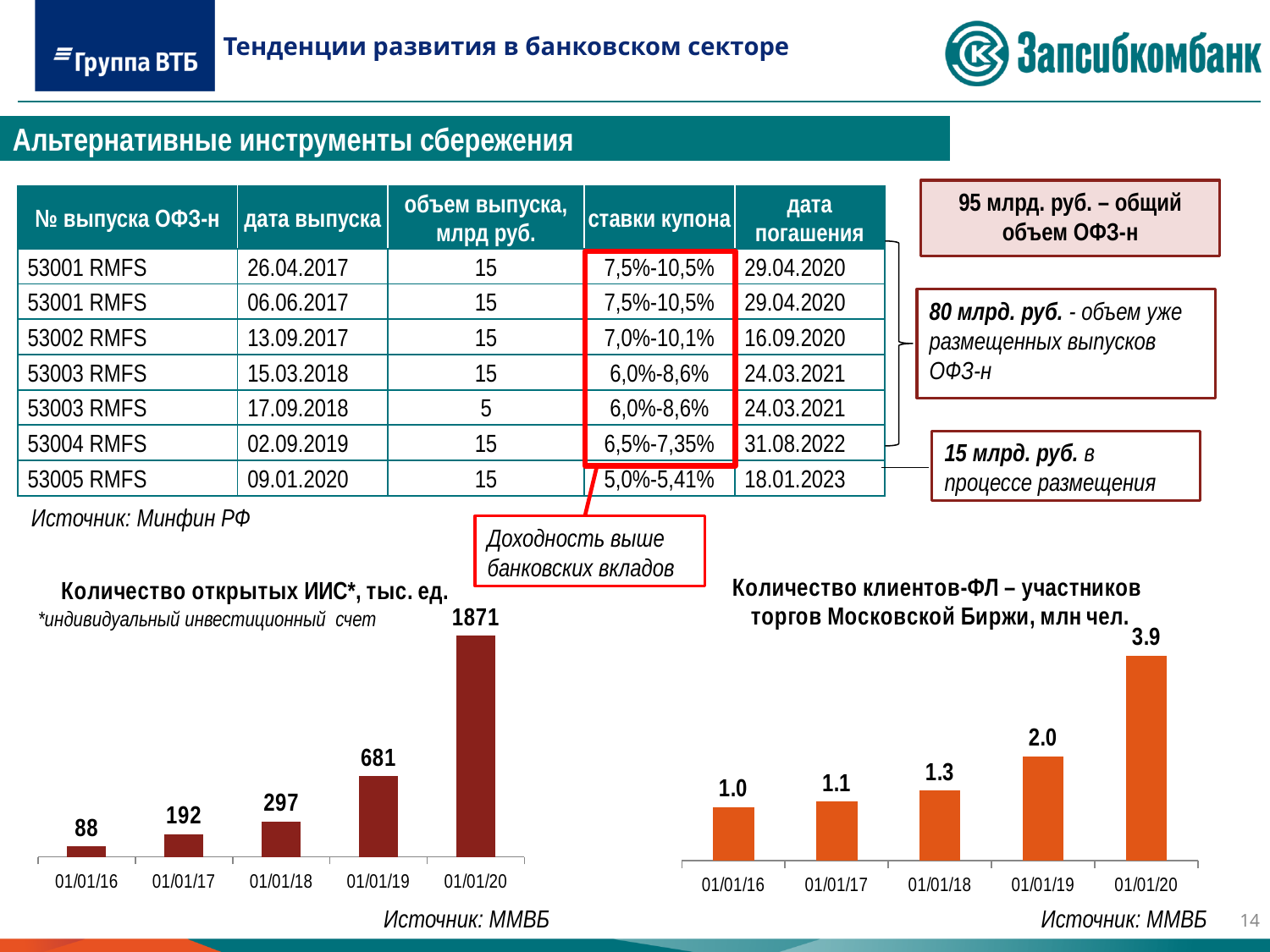
In the chart 'Количество открытых ИИС*, тыс. ед.', what is the value for 01/01/20? 1871 In the chart 'Количество открытых ИИС*, тыс. ед.', what is the difference between the values for 01/01/19 and 01/01/18? 384 In the chart 'Количество клиентов-ФЛ – участников торгов Московской Биржи, млн чел.', what is the value for 01/01/19? 2.0 What type of chart is the chart on the right, 'Количество клиентов-ФЛ – участников торгов Московской Биржи, млн чел.'? bar chart In the chart 'Количество клиентов-ФЛ – участников торгов Московской Биржи, млн чел.', what is the value for 01/01/18? 1.3 In the chart 'Количество клиентов-ФЛ – участников торгов Московской Биржи, млн чел.', which is larger, the value for 01/01/17 or 01/01/18? 01/01/18 In the chart 'Количество клиентов-ФЛ – участников торгов Московской Биржи, млн чел.', which date has the highest value? 01/01/20 In the chart 'Количество открытых ИИС*, тыс. ед.', how many bars are plotted? 5 In the chart 'Количество открытых ИИС*, тыс. ед.', do the values rise or fall from 01/01/16 to 01/01/20? rise In the chart 'Количество открытых ИИС*, тыс. ед.', what is the value for 01/01/17? 192 In the chart 'Количество открытых ИИС*, тыс. ед.', which date has the lowest value? 01/01/16 In the chart 'Количество клиентов-ФЛ – участников торгов Московской Биржи, млн чел.', what is the difference between the values for 01/01/20 and 01/01/19? 1.9